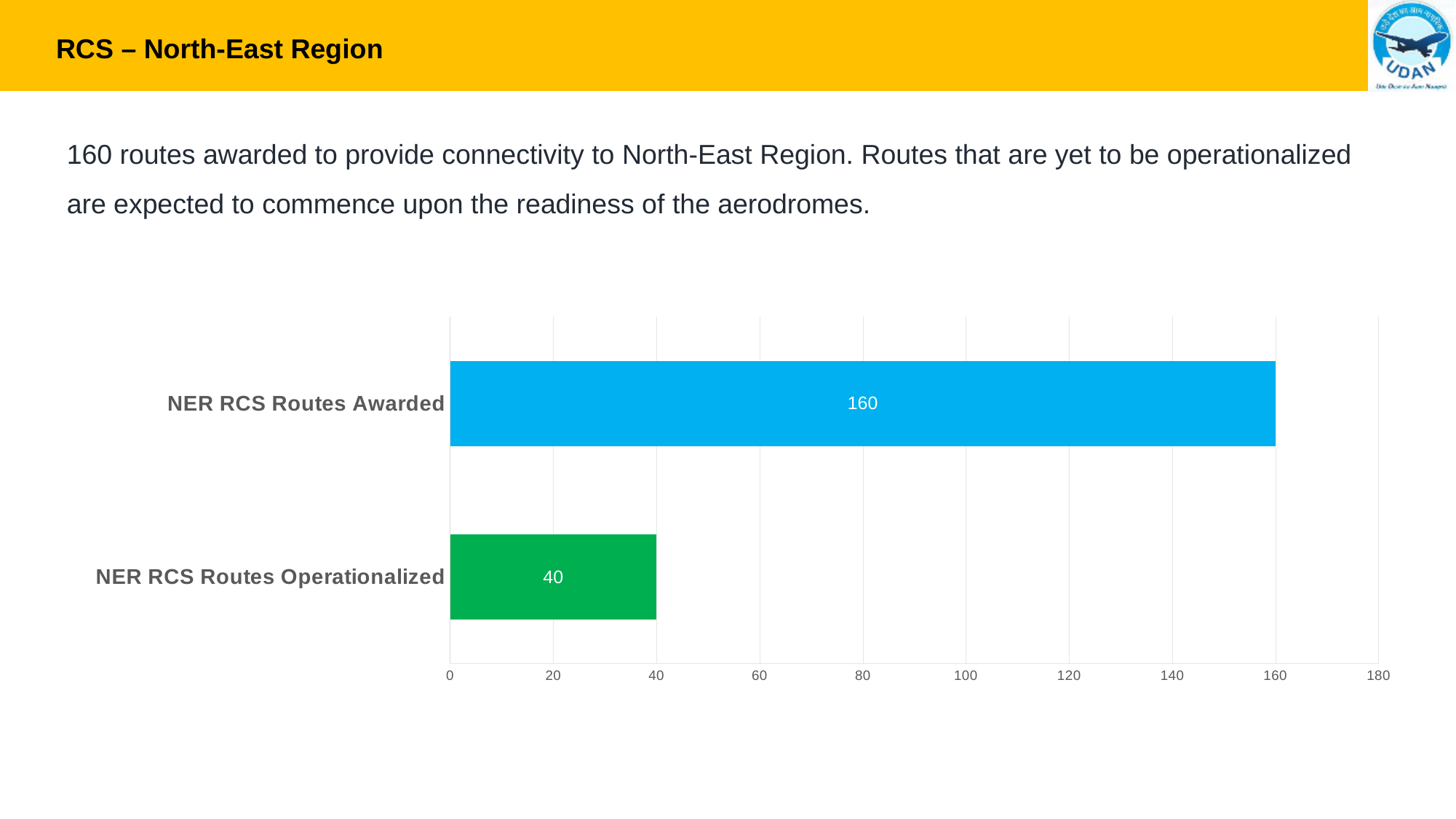
Is the value for NER RCS Routes Awarded greater or less than 140? greater What is the value for NER RCS Routes Operationalized? 40 What kind of chart is shown on the slide? bar chart What is the value for NER RCS Routes Awarded? 160 Which category has the lowest value? NER RCS Routes Operationalized What colour is the bar for NER RCS Routes Operationalized? green How many categories are shown in the chart? 2 Is the value for NER RCS Routes Operationalized greater or less than 100? less What is the difference between NER RCS Routes Awarded and NER RCS Routes Operationalized? 120 What is the maximum value shown on the x axis? 180 Which category has the highest value? NER RCS Routes Awarded Which is larger, NER RCS Routes Awarded or NER RCS Routes Operationalized? NER RCS Routes Awarded